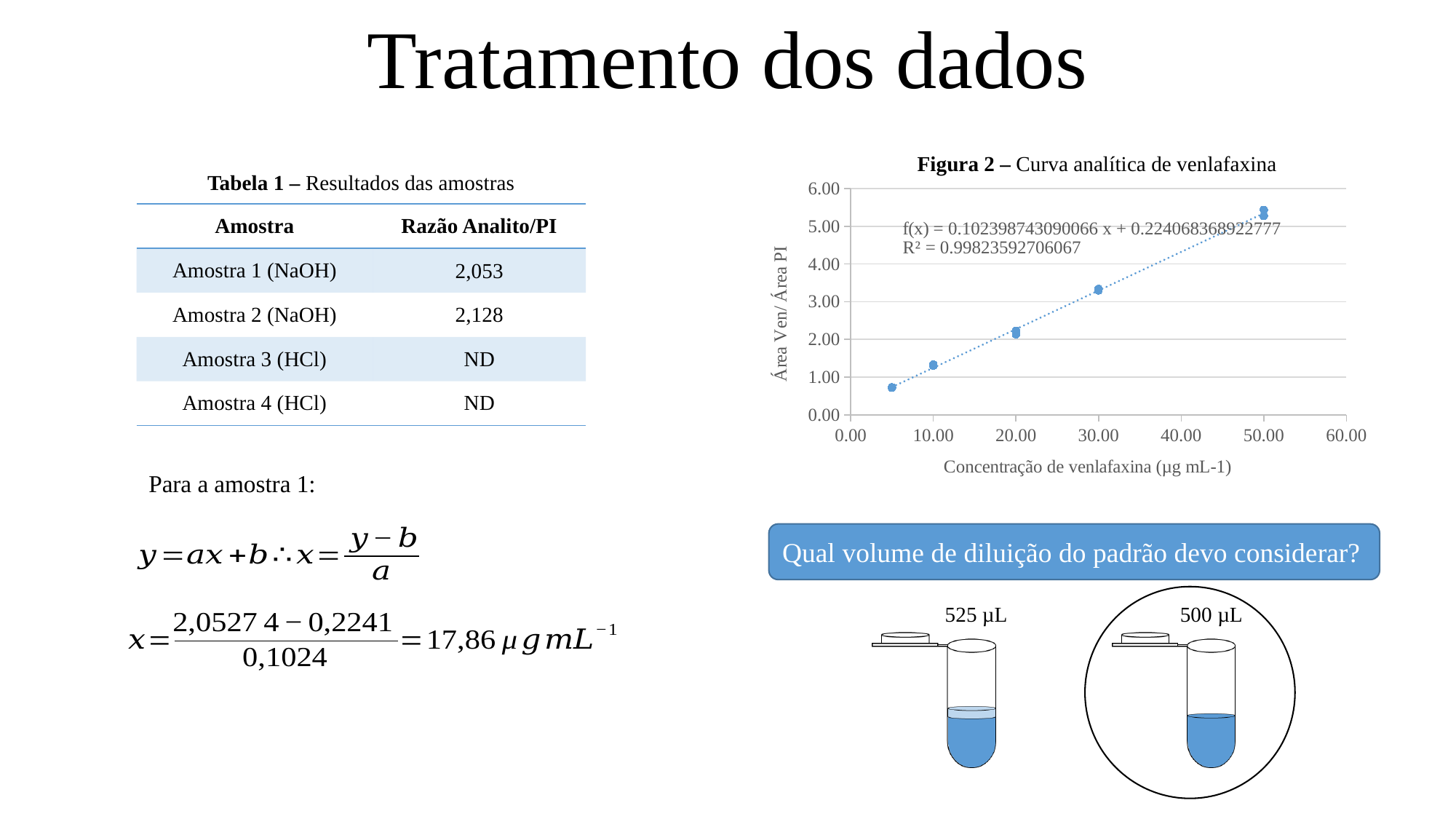
Which concentration level has the highest Área Ven/Área PI value? 50.00 What is the title of the chart on the slide? Figura 2 – Curva analítica de venlafaxina Is the Área Ven/Área PI value at a concentration of 30.00 greater or less than 3.00? greater What kind of chart is Figura 2 – Curva analítica de venlafaxina? scatter chart Is the Área Ven/Área PI value at a concentration of 5.00 greater or less than 1.00? less Is the Área Ven/Área PI value at a concentration of 50.00 greater or less than 5.00? greater Which concentration level has the lowest Área Ven/Área PI value? 5.00 Do the plotted values rise or fall as the concentration of venlafaxina increases? rise What R² value is shown on the chart? R² = 0.99823592706067 How many distinct concentration levels are plotted on the chart? 5